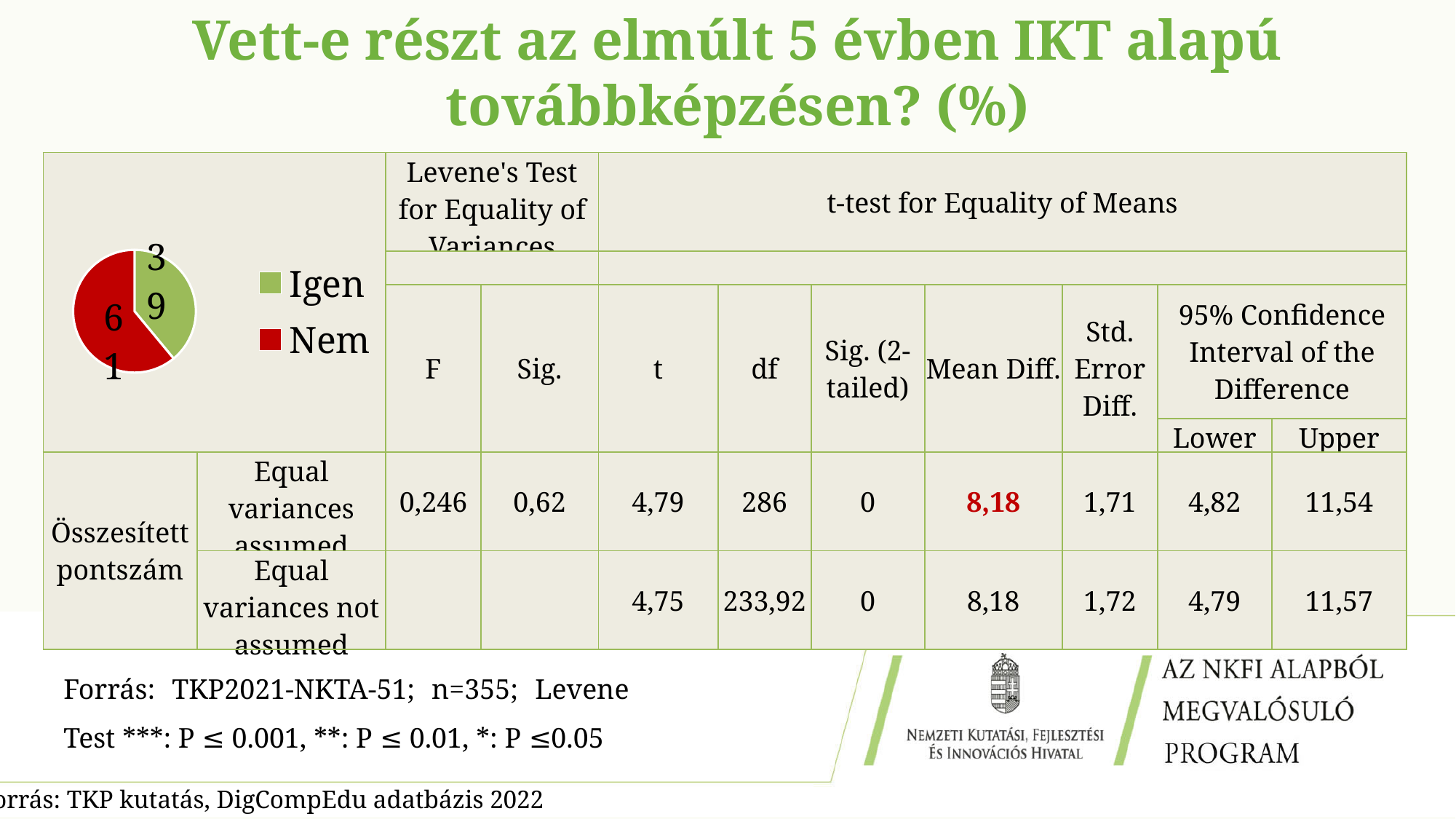
What is the value shown for the Igen slice of the pie chart? 39 What colour is the Igen slice in the pie chart? green Which slice of the pie chart is the largest? Nem Which is larger in the pie chart, Igen or Nem? Nem How many entries does the legend of the pie chart list? 2 Which slice of the pie chart is the smallest? Igen What is the value shown for the Nem slice of the pie chart? 61 What kind of chart is shown on the slide? pie chart What is the difference between the Nem and Igen values in the pie chart? 22 How many slices does the pie chart have? 2 What share of the pie chart does the Nem slice represent? 61% What colour is the Nem slice in the pie chart? red